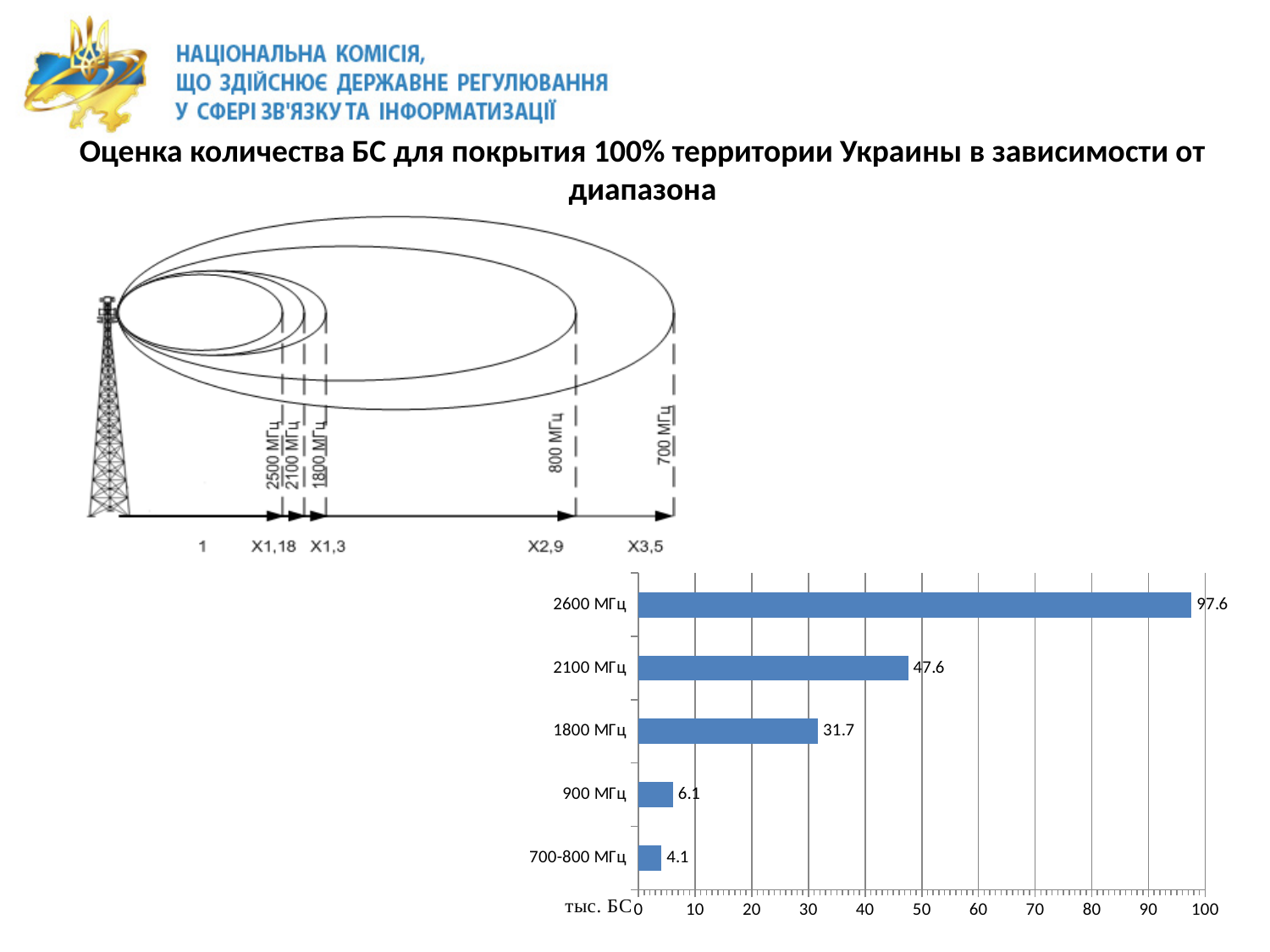
What is the value for 2600 МГц in the bar chart? 97.6 What is the value for 700-800 МГц in the bar chart? 4.1 Which category has the highest value in the bar chart? 2600 МГц Is the value for 1800 МГц in the bar chart greater or less than 30? greater What is the difference between the values for 2600 МГц and 2100 МГц in the bar chart? 50 What unit label is shown at the bottom left of the bar chart's axis? тыс. БС How many categories are shown in the bar chart? 5 Which is larger in the bar chart: the value for 2100 МГц or the value for 1800 МГц? 2100 МГц What is the value for 1800 МГц in the bar chart? 31.7 What kind of chart is shown at the bottom right of the slide? bar chart What is the difference between the values for 900 МГц and 700-800 МГц in the bar chart? 2 Which category has the lowest value in the bar chart? 700-800 МГц